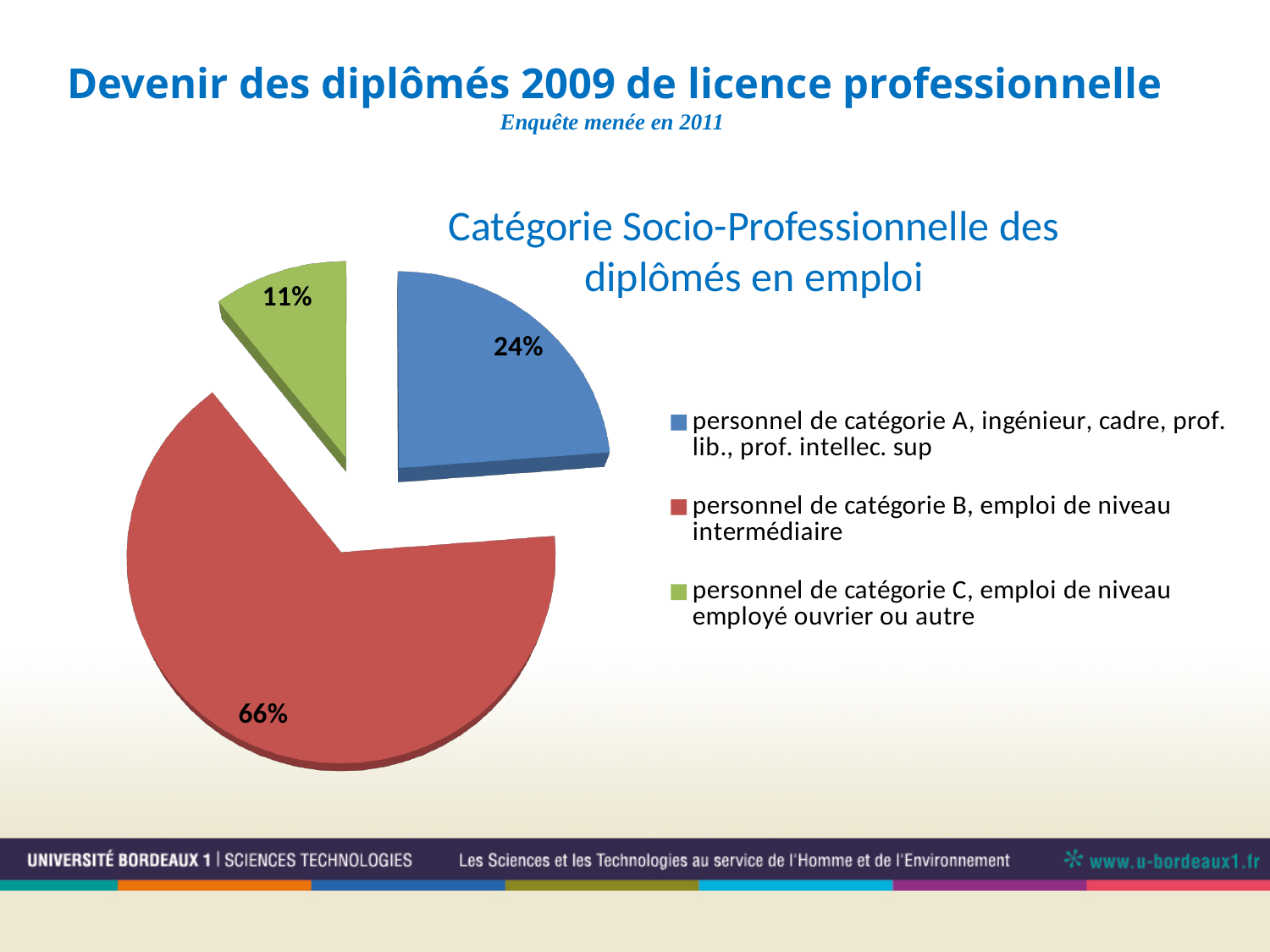
What is the difference in percentage points between the catégorie B slice and the catégorie A slice? 42 What share of the pie does 'personnel de catégorie C, emploi de niveau employé ouvrier ou autre' represent? 11% What is the difference in percentage points between the catégorie A slice and the catégorie C slice? 13 What kind of chart is shown on the slide? pie chart What is the title of the chart? Catégorie Socio-Professionnelle des diplômés en emploi What share of the pie does 'personnel de catégorie A, ingénieur, cadre, prof. lib., prof. intellec. sup' represent? 24% What share of the pie does 'personnel de catégorie B, emploi de niveau intermédiaire' represent? 66% What colour is the slice for 'personnel de catégorie B, emploi de niveau intermédiaire'? red Which category has the largest slice of the pie? personnel de catégorie B, emploi de niveau intermédiaire How many categories are shown in the pie chart? 3 Which category has the smallest slice of the pie? personnel de catégorie C, emploi de niveau employé ouvrier ou autre Which is larger, the catégorie A slice or the catégorie C slice? catégorie A